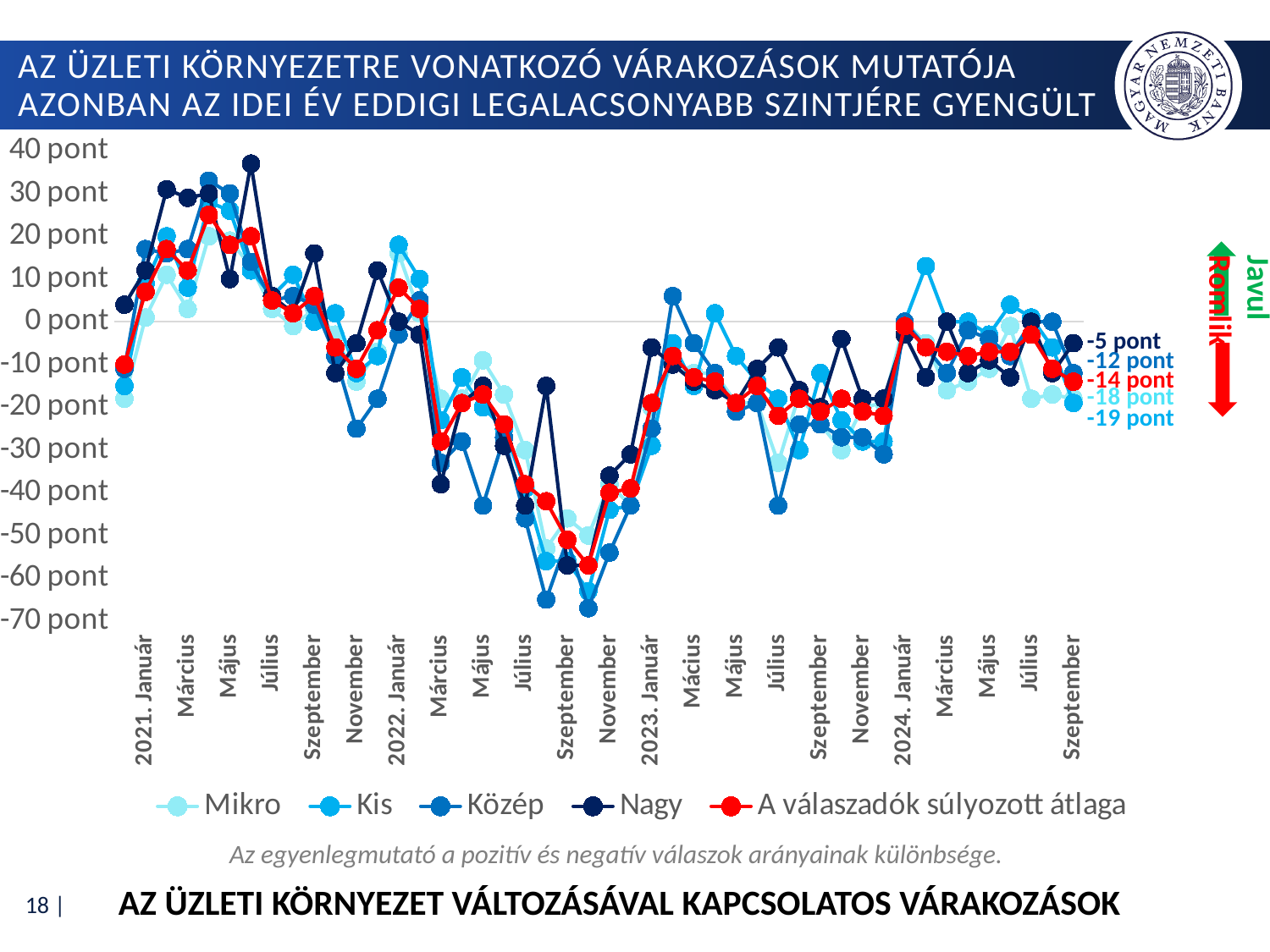
Which series has the highest value at the last point (2024 Szeptember)? Nagy What is the value of 'A válaszadók súlyozott átlaga' at the last point (2024 Szeptember)? -14 pont What kind of chart is shown on the slide? line chart Which series has the lowest value at the last point (2024 Szeptember)? Kis What is the value of the Nagy series at the last point (2024 Szeptember)? -5 pont At the last point (2024 Szeptember), which is higher: Nagy or A válaszadók súlyozott átlaga? Nagy At the last point (2024 Szeptember), what is the difference between the Nagy value and the weighted average (A válaszadók súlyozott átlaga)? 9 pont Is the value of 'A válaszadók súlyozott átlaga' in 2022 Szeptember greater or less than -40 pont? less Which legend entry is drawn in red? A válaszadók súlyozott átlaga What is the value of the Közép series at the last point (2024 Szeptember)? -12 pont How many series does the legend list? 5 Does 'A válaszadók súlyozott átlaga' rise or fall between 2022. Január and 2022 Szeptember? fall